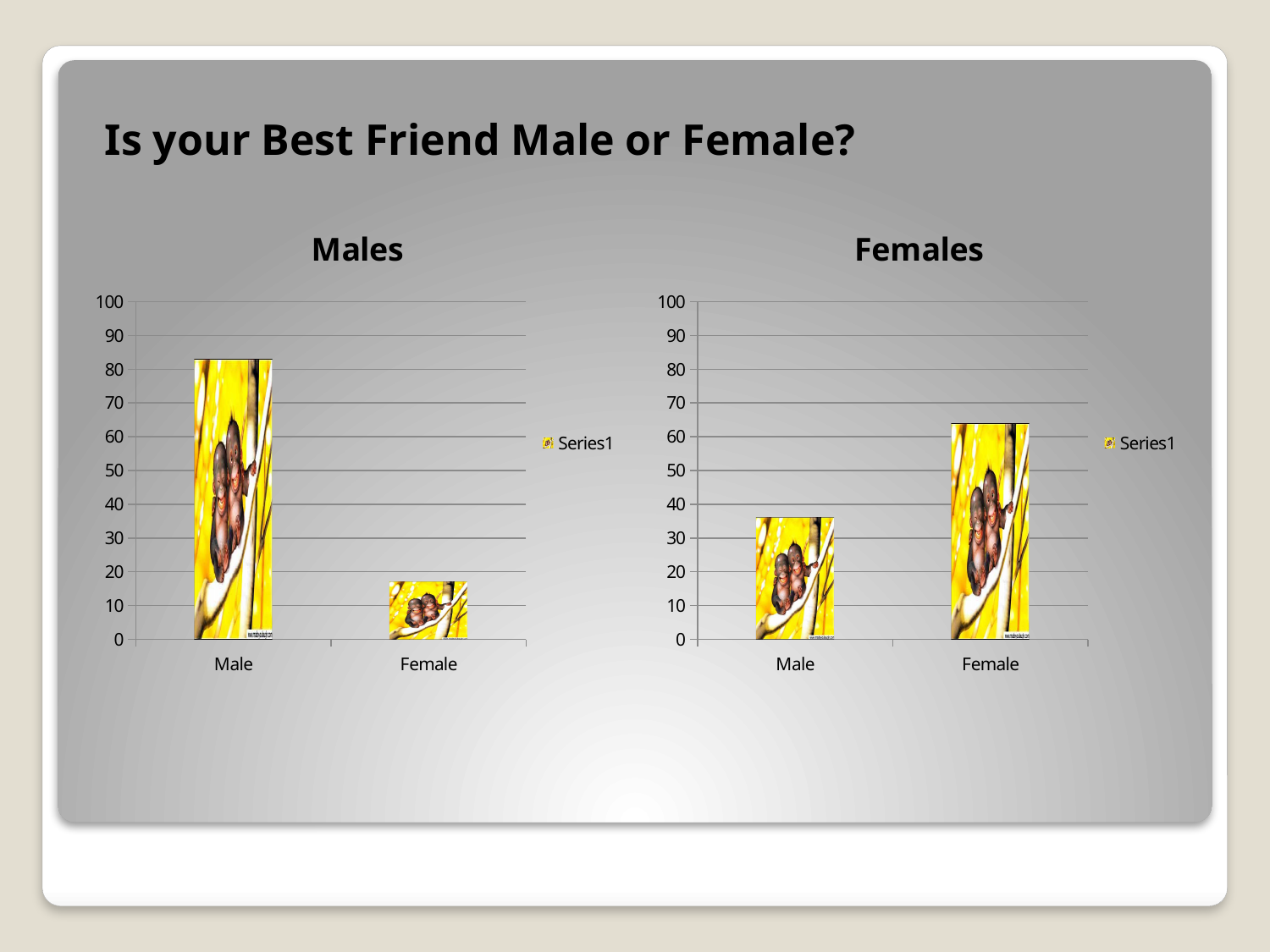
In the Females chart, which category has the highest value? Female In the Males chart, which category has the lowest value? Female How many series does the legend of the Females chart list? 1 In the Females chart, is the value for Female greater or less than 60? greater In the Females chart, which category has the lowest value? Male In the Males chart, is the value for Male greater or less than 80? greater In the Females chart, which is larger, the value for Male or the value for Female? Female In the Females chart, is the value for Male greater or less than 40? less In the Males chart, which category has the highest value? Male What kind of chart is the Males chart? bar chart How many categories are shown on the x axis of the Males chart? 2